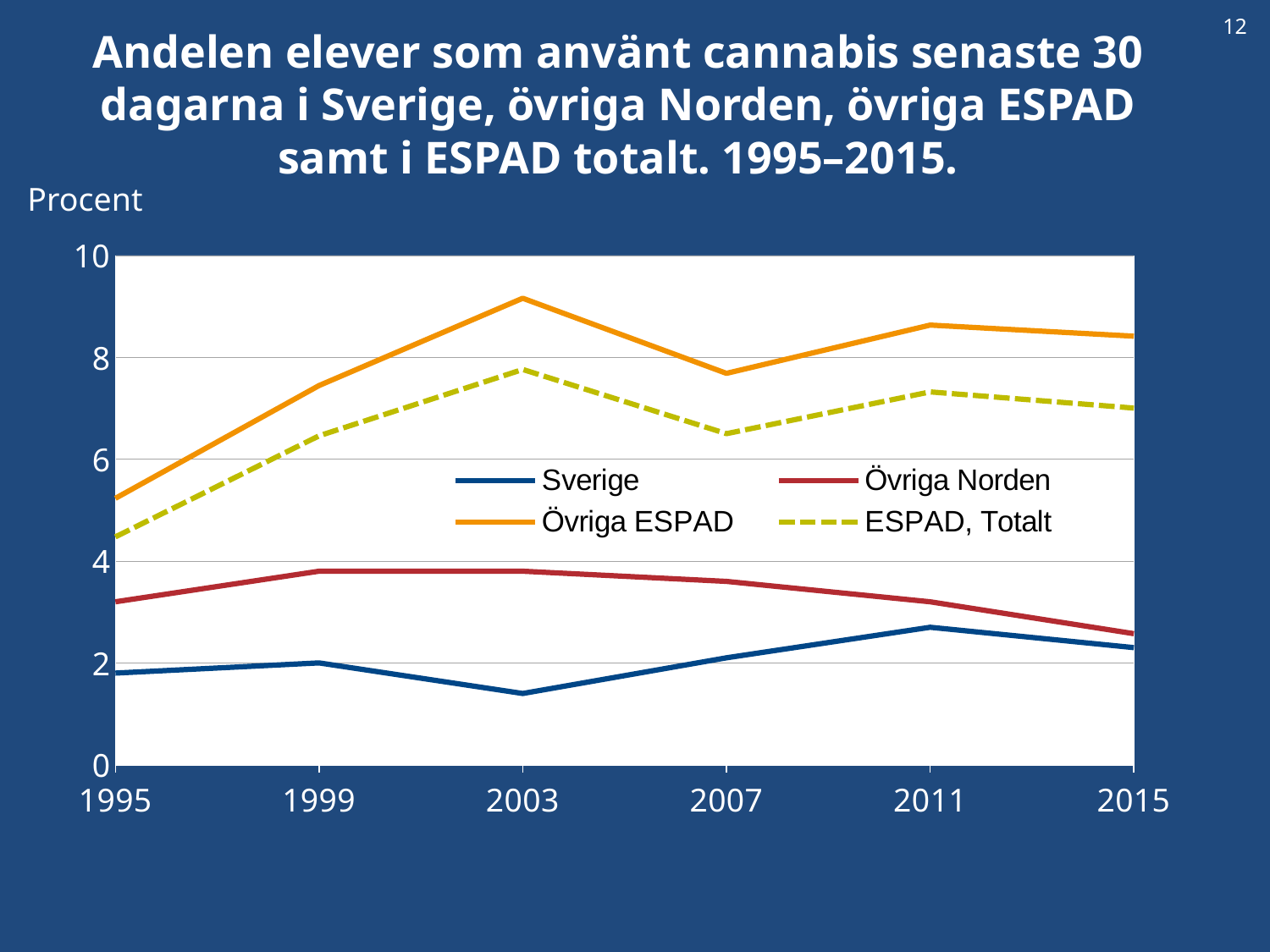
Is the value for Sverige in 2003 greater or less than 2? less Is the value for Övriga Norden in 1999 greater or less than 4? less Is the value for Övriga ESPAD in 2003 greater or less than 8? greater In which year does the Sverige line reach its lowest point? 2003 Which series is drawn with a dashed line? ESPAD, Totalt How many series does the legend list? 4 What kind of chart is shown on the slide? line chart Does the Övriga Norden line rise or fall between 1999 and 2015? fall Which is larger in 2007, the value for Övriga Norden or the value for Sverige? Övriga Norden How many years are marked on the x axis? 6 Which series has the highest values across the whole period? Övriga ESPAD In which year does the Övriga ESPAD line reach its highest point? 2003